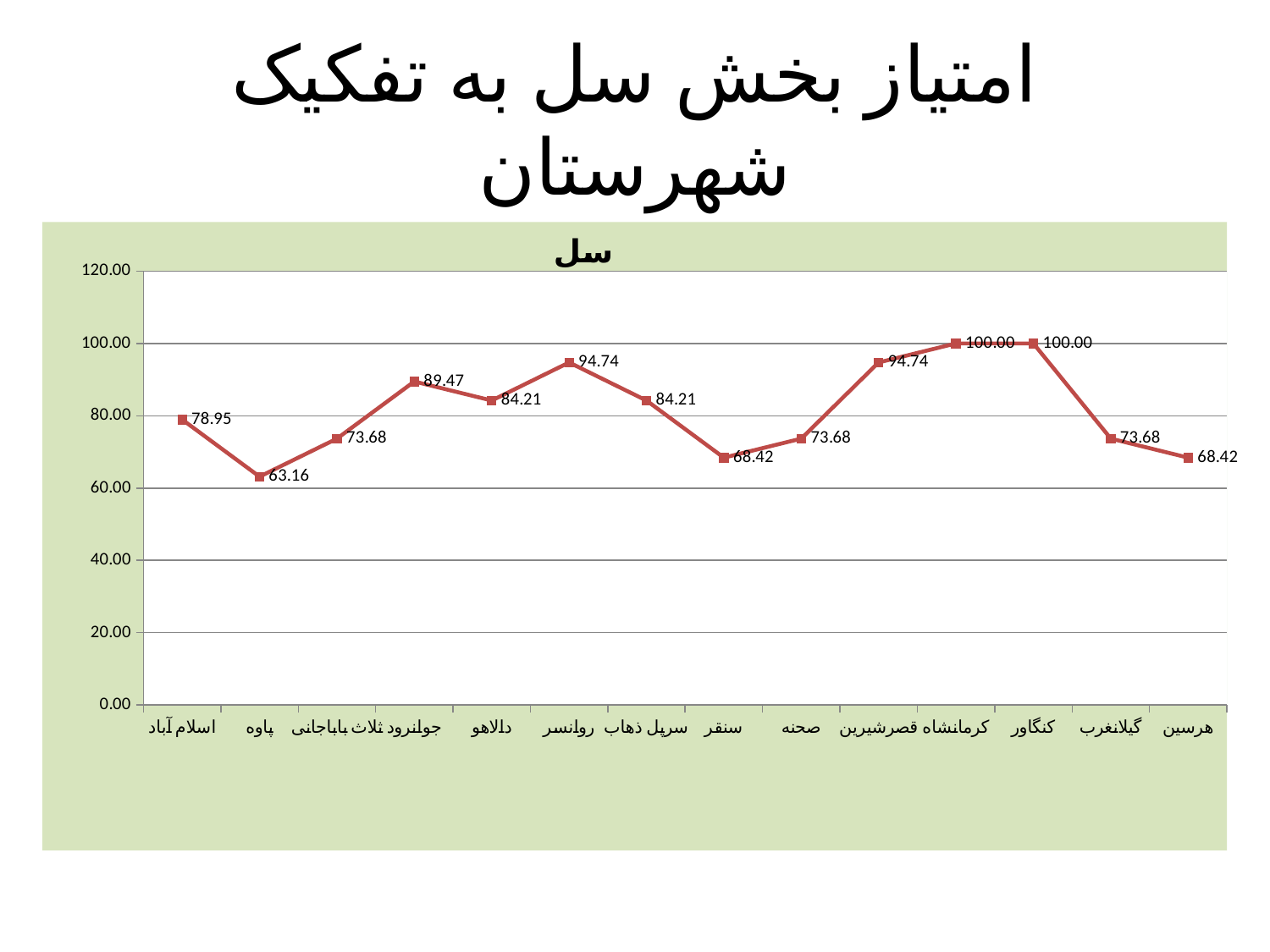
What type of chart is shown on the slide? line chart What is the value for پاوه? 63.16 Which is larger, the value for دالاهو or the value for سنقر? دالاهو Which category has the lowest value? پاوه What is the value for روانسر? 94.74 What is the value for اسلام آباد? 78.95 Which categories share the highest value of 100.00? کرمانشاه and کنگاور What is the value for جوانرود? 89.47 What is the difference between the values for کرمانشاه and هرسین? 31.58 How many categories are plotted on the x axis? 14 What is the title shown above the chart's plot area? سل Is the value for قصرشیرین greater or less than 80.00? greater